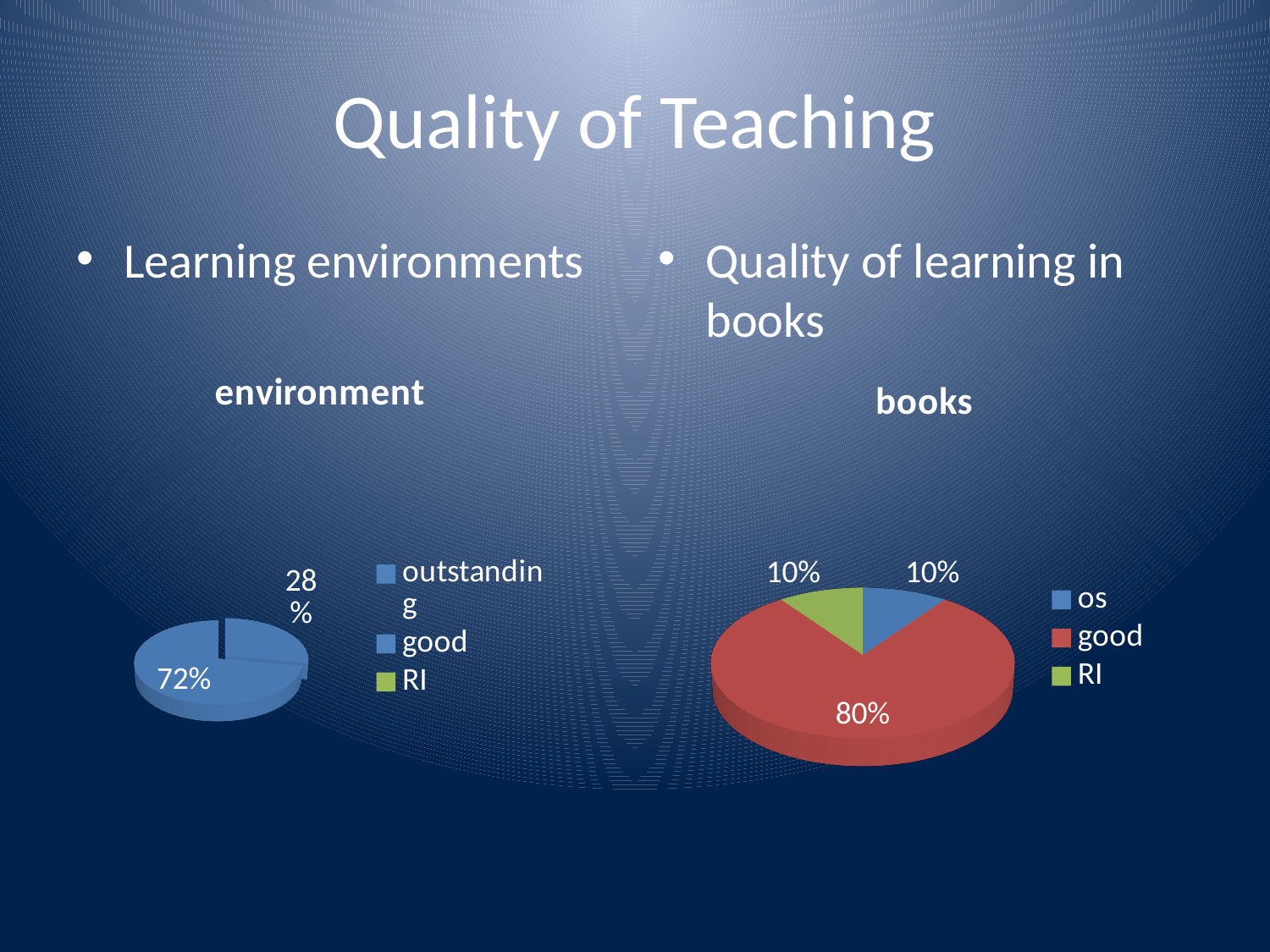
In the books chart, which category has the largest share? good In the books chart, what percentage is shown for os? 10% What kind of chart is the environment chart? pie chart In the books chart, what percentage is shown for RI? 10% In the books chart, is the share for good larger or smaller than the share for os? larger In the environment chart, what percentage is shown on the smallest slice? 28% In the books chart, what percentage is shown for good? 80% How many entries does the legend of the books chart list? 3 What kind of chart is the books chart? pie chart In the environment chart, what percentage is shown on the largest slice? 72% In the books chart, what is the difference between the good share and the RI share? 70 percentage points What is the title of the chart on the left side of the slide? environment